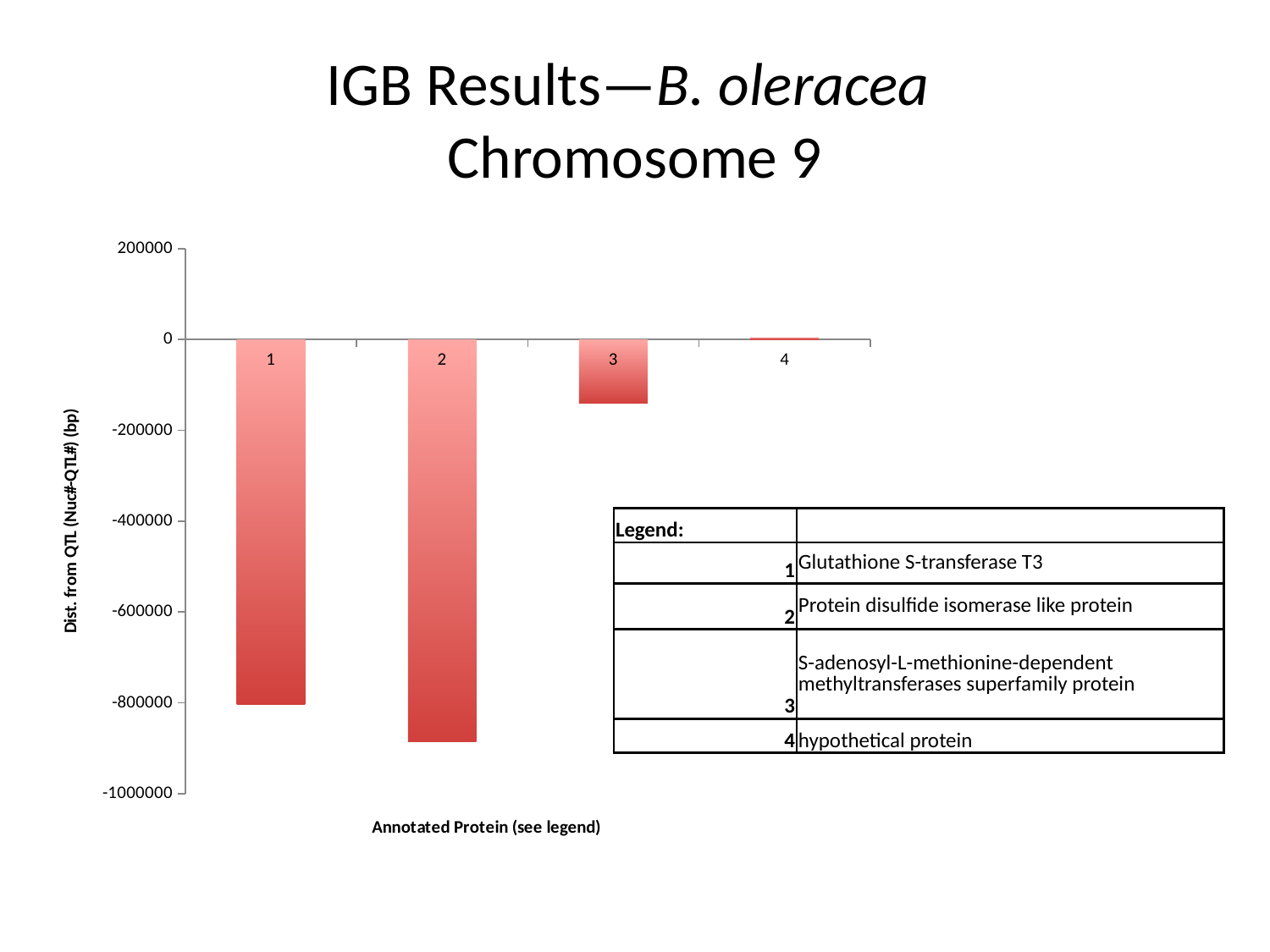
Which has the larger value, category 1 or category 2? 1 Is the value for category 3 greater or less than 0? less What kind of chart is shown on the slide? bar chart Which has the larger value, category 1 or category 3? 3 Which category has the lowest (most negative) value on the chart? 2 How many categories (bars) are plotted on the chart? 4 Which category has the highest value on the chart? 4 Is the value for category 1 greater or less than -600000? less What is the title of the x axis of the chart? Annotated Protein (see legend) According to the legend table, which protein does category 1 correspond to? Glutathione S-transferase T3 Is the value for category 3 greater or less than -200000? greater